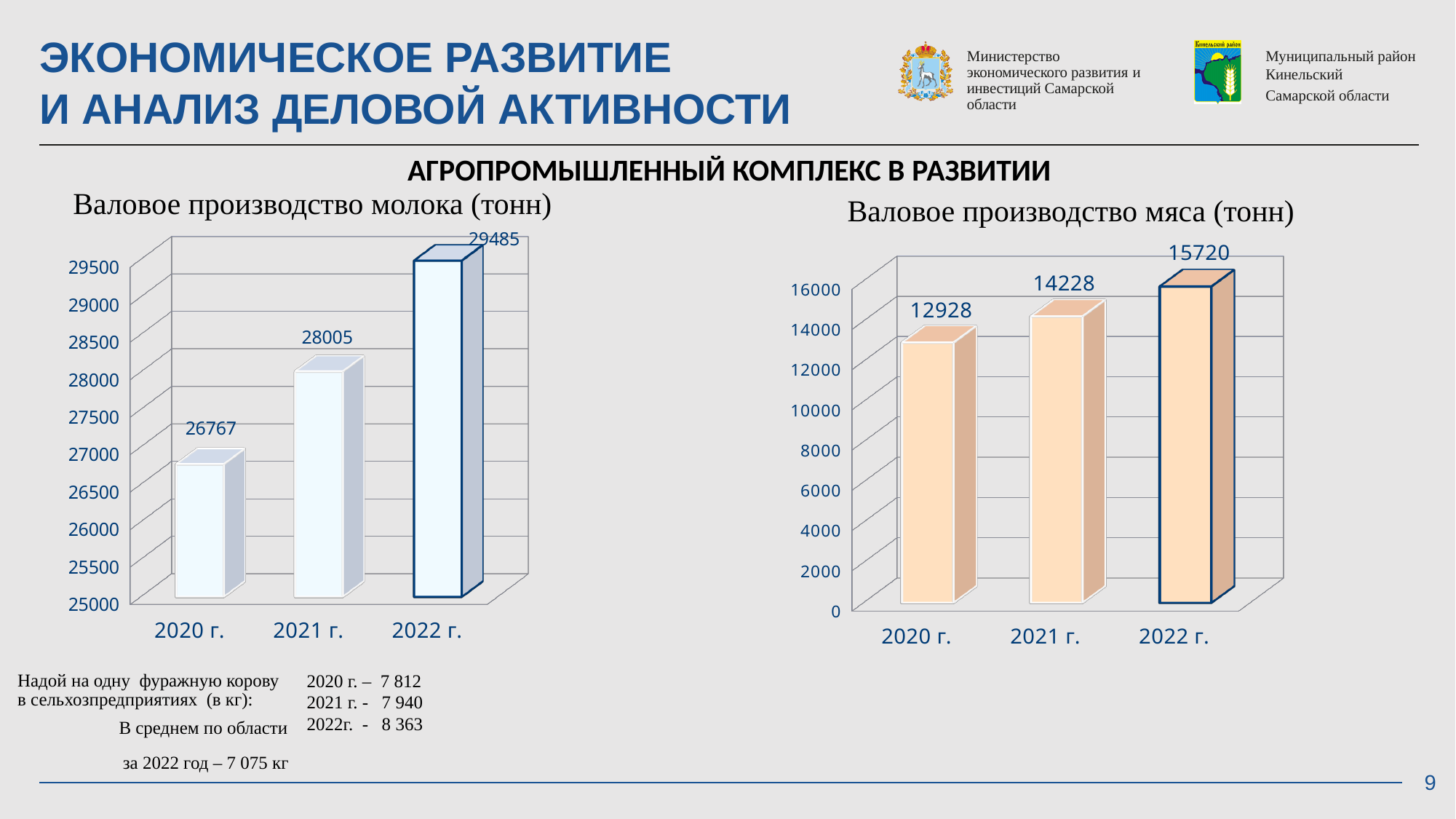
In the 'Валовое производство молока (тонн)' chart, what is the value for 2022 г.? 29485 In the 'Валовое производство молока (тонн)' chart, which year has the lowest value? 2020 г. In the 'Валовое производство мяса (тонн)' chart, is the value for 2020 г. greater or less than 14000? less In the 'Валовое производство молока (тонн)' chart, what is the difference between the 2022 г. and 2021 г. values? 1480 How many years are shown in the 'Валовое производство молока (тонн)' chart? 3 In the 'Валовое производство мяса (тонн)' chart, which year has the highest value? 2022 г. In the 'Валовое производство молока (тонн)' chart, do the values rise or fall from 2020 г. to 2022 г.? rise In the 'Валовое производство мяса (тонн)' chart, what is the value for 2021 г.? 14228 In the 'Валовое производство мяса (тонн)' chart, what is the difference between the 2021 г. and 2020 г. values? 1300 In the 'Валовое производство мяса (тонн)' chart, what is the value for 2022 г.? 15720 In the 'Валовое производство молока (тонн)' chart, what is the value for 2020 г.? 26767 What type of chart is the 'Валовое производство мяса (тонн)' chart? bar chart